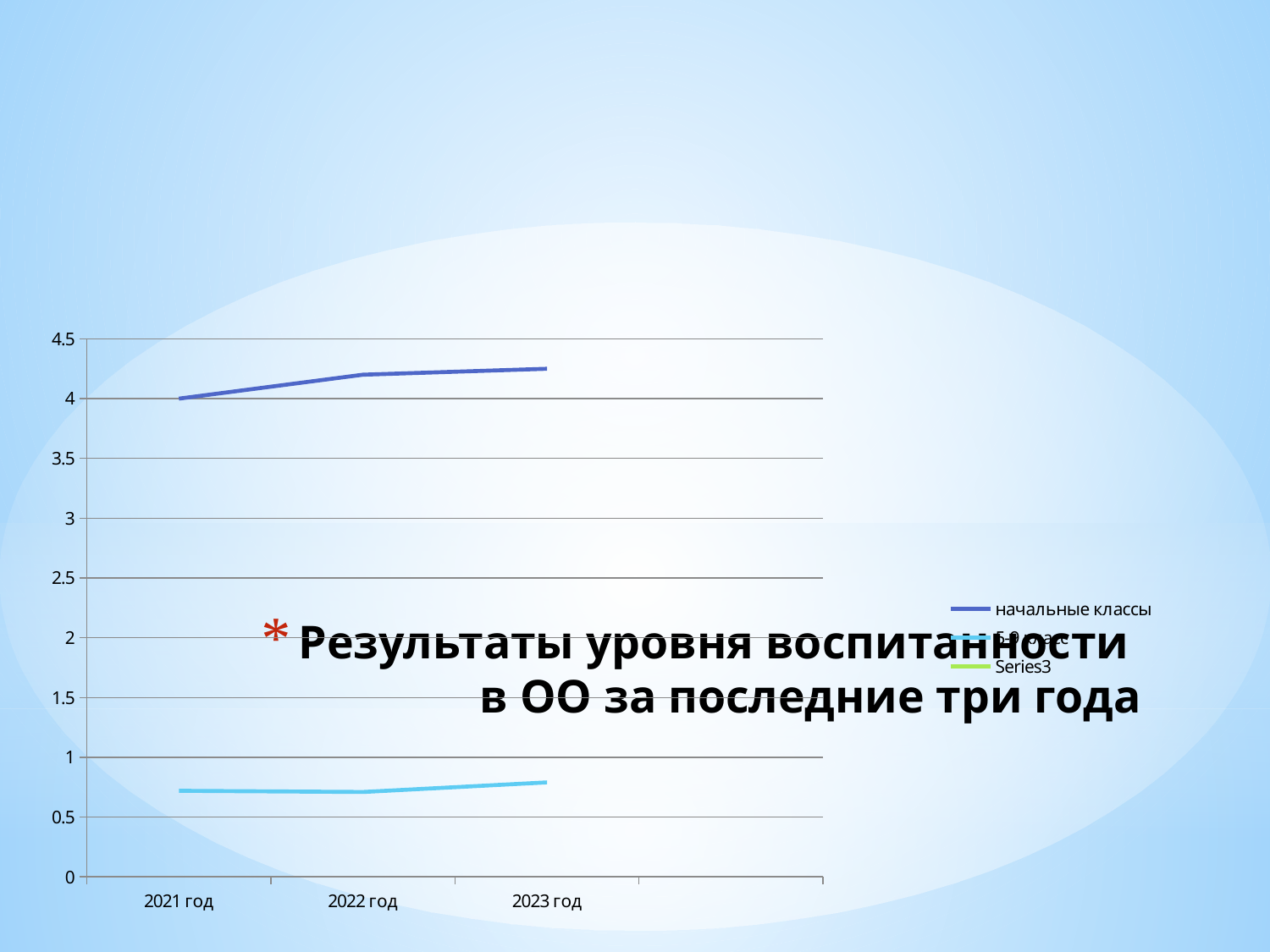
How many years are shown on the x axis of the chart? 3 Which series is plotted with the dark blue line? начальные классы What is the value for начальные классы in 2021 год? 4 Is the value for начальные классы in 2023 год greater or less than 4? greater In which year is the value for начальные классы lowest? 2021 год What kind of chart is shown on the slide? line chart Is the value for начальные классы in 2021 год greater or less than 3.5? greater Is the value for начальные классы in 2022 год greater or less than 4.5? less Does the line for начальные классы rise or fall from 2021 год to 2023 год? rise How many series does the chart legend list? 3 What is the first year shown on the x axis? 2021 год